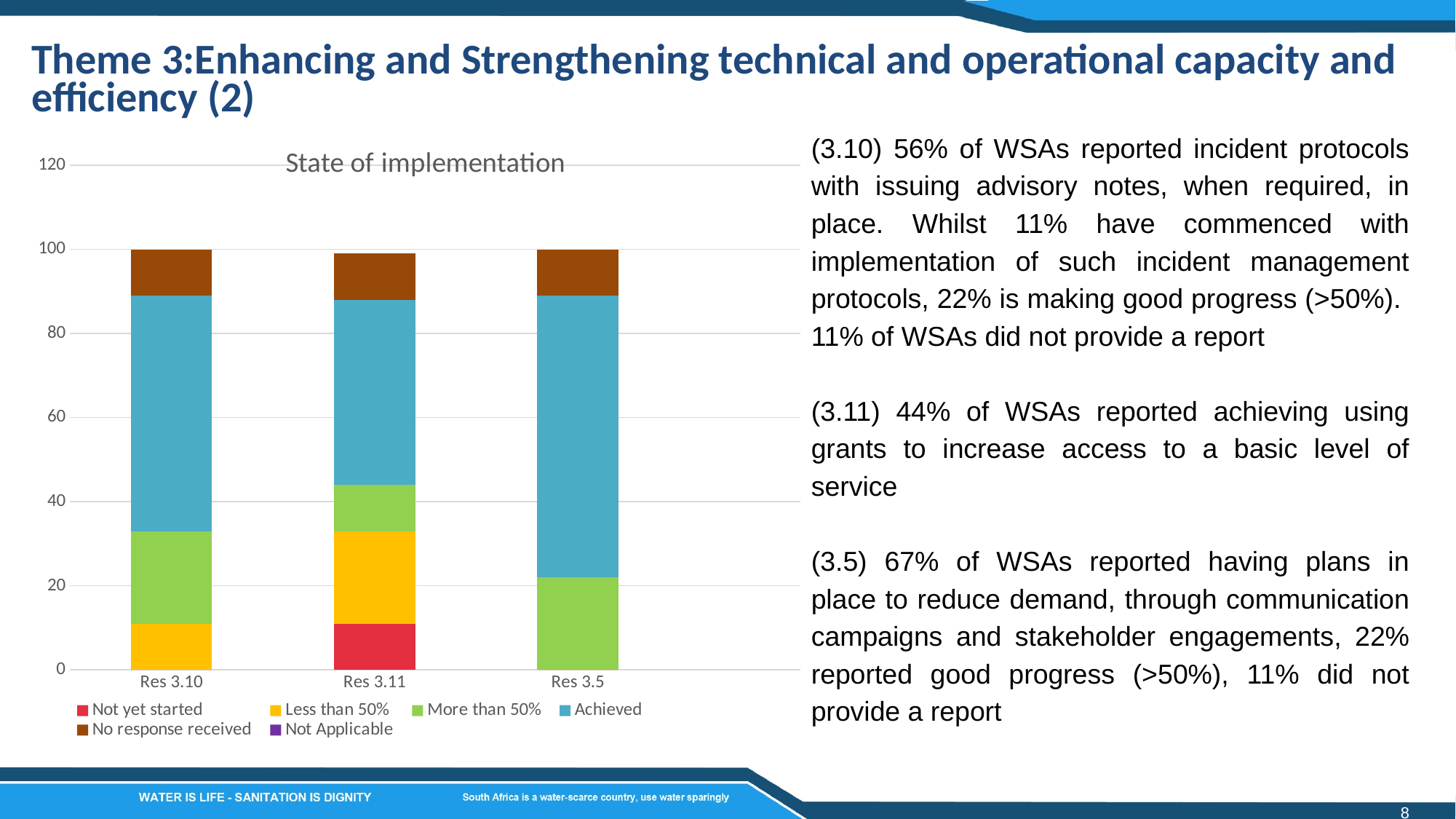
What is the title of the chart? State of implementation Is the 'Achieved' segment larger for Res 3.5 or for Res 3.11? Res 3.5 How many categories are shown on the x axis of the chart? 3 What kind of chart is shown on the slide? Stacked bar chart Which category has the largest 'Achieved' segment? Res 3.5 Which category is the only one with a 'Not yet started' segment? Res 3.11 Is the 'Less than 50%' value for Res 3.10 greater or less than 20? less Is the 'Achieved' value for Res 3.11 greater or less than 60? less How many series does the chart's legend list? 6 Is the 'Not yet started' value for Res 3.11 greater or less than 20? less Is the 'More than 50%' segment larger for Res 3.10 or for Res 3.11? Res 3.10